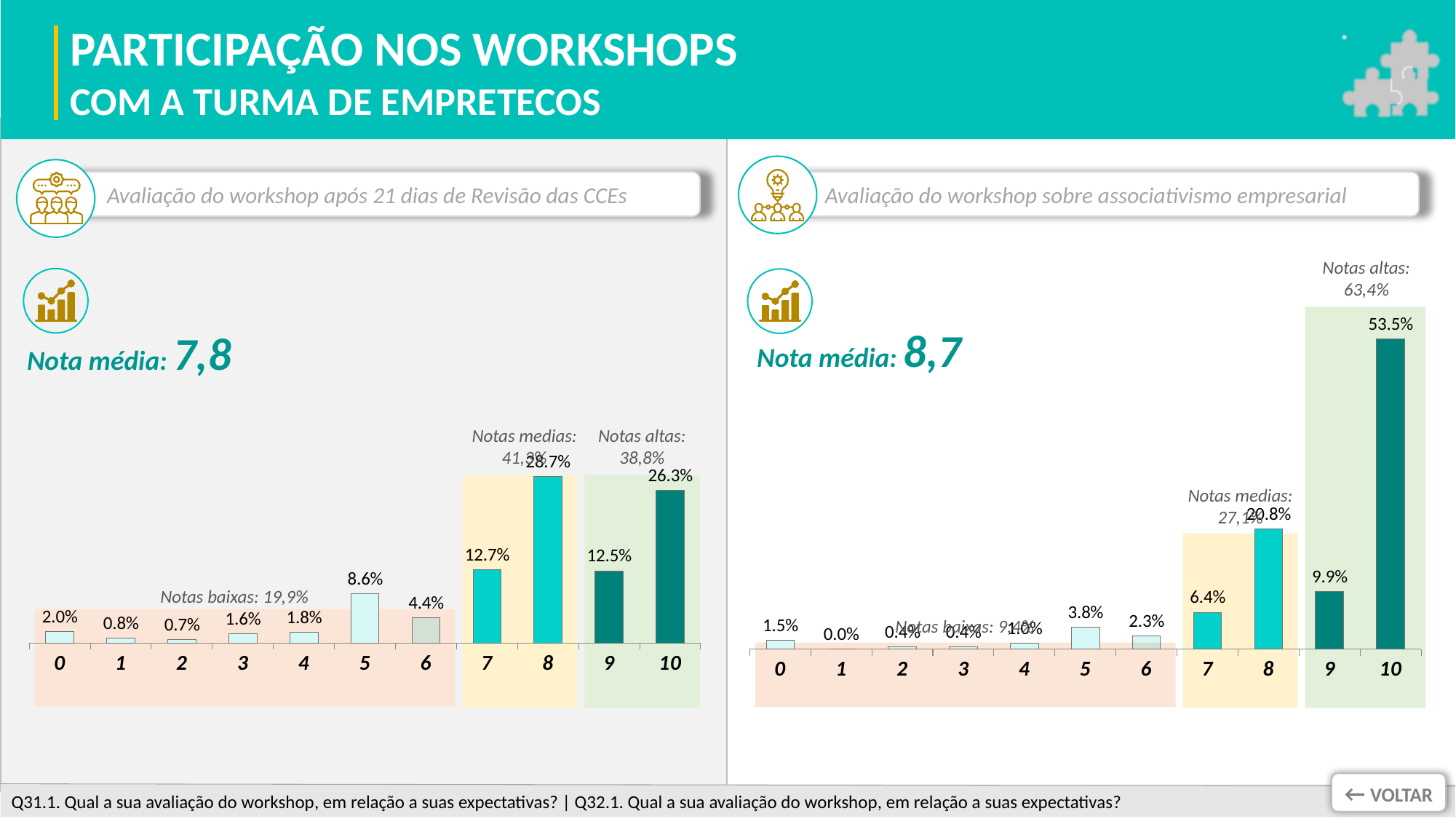
What is the 'Nota média' shown for the workshop 'sobre associativismo empresarial'? 8,7 In the chart 'Avaliação do workshop sobre associativismo empresarial', what is the difference between the percentages for score 10 and score 8? 32.7% How many score categories are shown on the x axis of the chart 'Avaliação do workshop sobre associativismo empresarial'? 11 In the chart 'Avaliação do workshop sobre associativismo empresarial', what percentage is shown for score 7? 6.4% In the chart 'Avaliação do workshop após 21 dias de Revisão das CCEs', which is larger: the percentage for score 7 or for score 9? Score 7 In the chart 'Avaliação do workshop após 21 dias de Revisão das CCEs', what percentage is shown for score 8? 28.7% In the chart 'Avaliação do workshop após 21 dias de Revisão das CCEs', which score has the highest percentage? 8 In the chart 'Avaliação do workshop após 21 dias de Revisão das CCEs', what percentage is shown for score 5? 8.6% In the chart 'Avaliação do workshop sobre associativismo empresarial', which score has the lowest percentage? 1 In the chart 'Avaliação do workshop sobre associativismo empresarial', what percentage is shown for score 10? 53.5% In the chart 'Avaliação do workshop após 21 dias de Revisão das CCEs', what is the difference between the percentages for score 8 and score 10? 2.4% What type of chart is used for 'Avaliação do workshop após 21 dias de Revisão das CCEs'? Bar chart